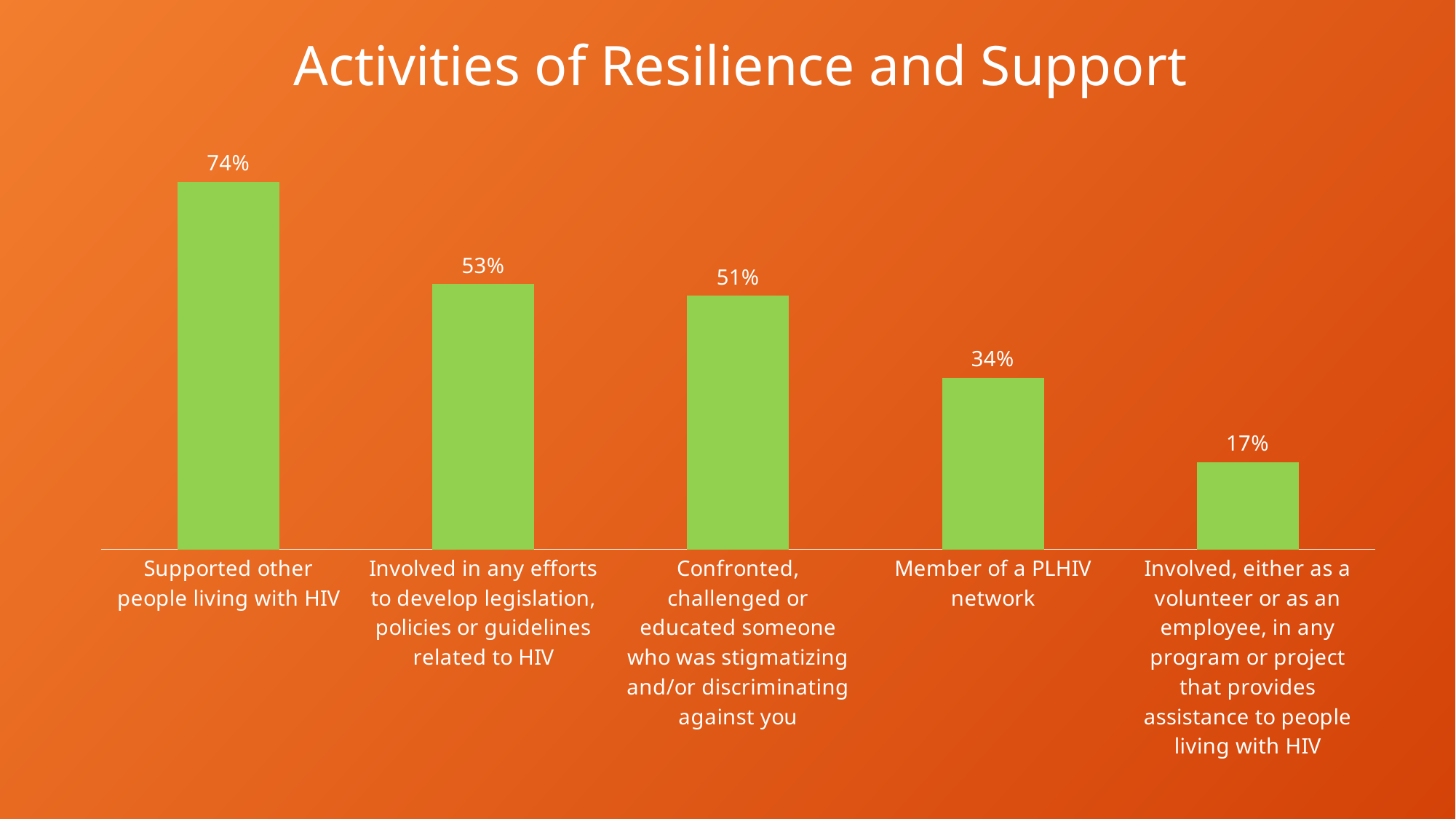
Which activity has the lowest percentage? Involved, either as a volunteer or as an employee, in any program or project that provides assistance to people living with HIV What percentage is shown for 'Involved in any efforts to develop legislation, policies or guidelines related to HIV'? 53% Which is larger: 'Member of a PLHIV network' or the volunteer/employee program activity? Member of a PLHIV network What is the value for 'Member of a PLHIV network'? 34% What is the difference between 'Supported other people living with HIV' and 'Member of a PLHIV network'? 40% Which activity has the highest percentage? Supported other people living with HIV What percentage is shown for 'Supported other people living with HIV'? 74% What is the difference between the legislation/policies activity and the confronted/challenged activity? 2% What is the value for 'Confronted, challenged or educated someone who was stigmatizing and/or discriminating against you'? 51% What is the title of the chart? Activities of Resilience and Support What kind of chart is this? Bar chart How many activities are shown in the chart? 5